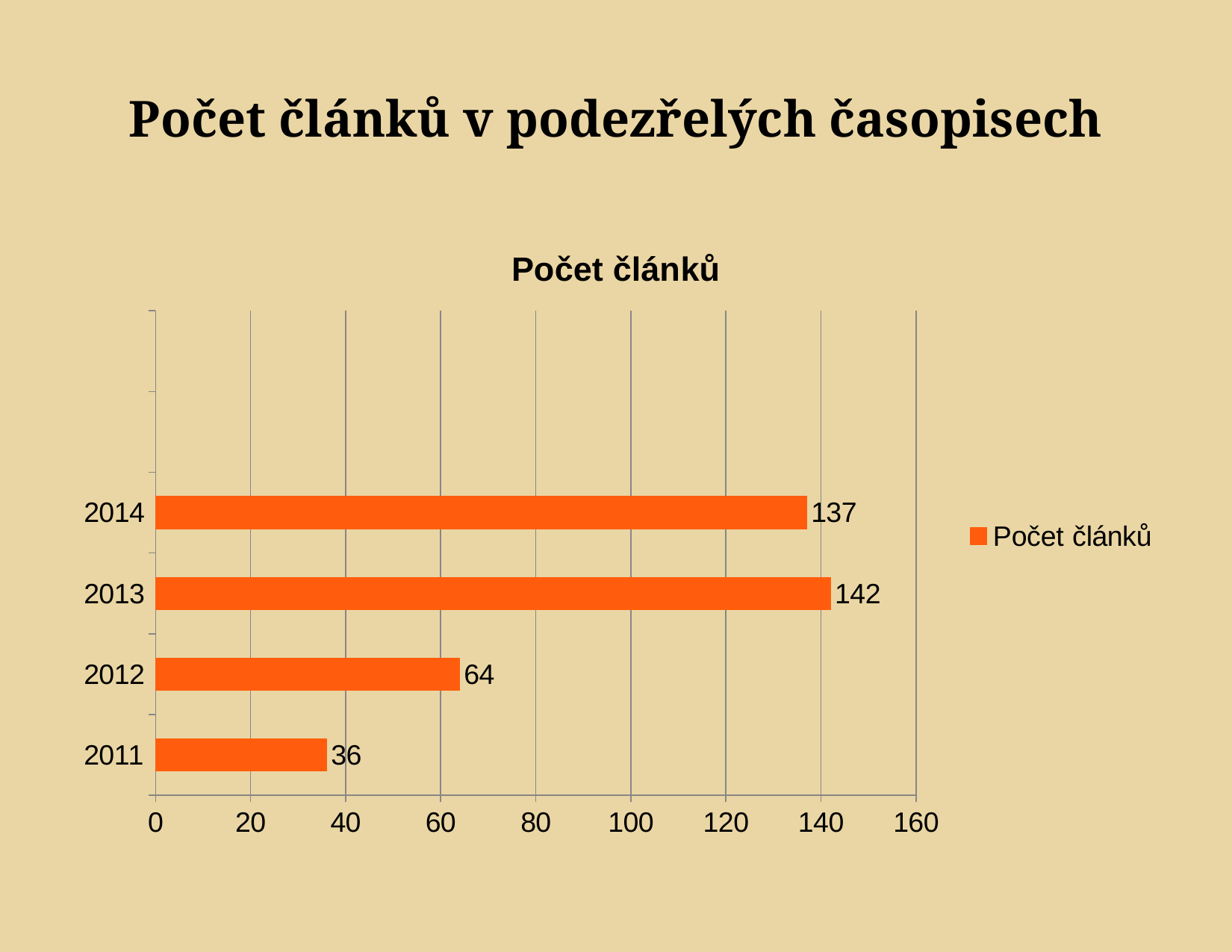
What is the difference between the values for 2012 and 2011? 28 Which is larger, the value for 2012 or the value for 2014? 2014 What is the value for 2014? 137 Which year has the highest number of articles? 2013 What is the difference between the values for 2013 and 2014? 5 Which year has the lowest number of articles? 2011 What is the value for 2011? 36 What kind of chart is shown on the slide? bar chart Is the value for 2013 greater or less than 140? greater What is the value for 2012? 64 What is the title of the chart? Počet článků How many years are shown on the chart? 4